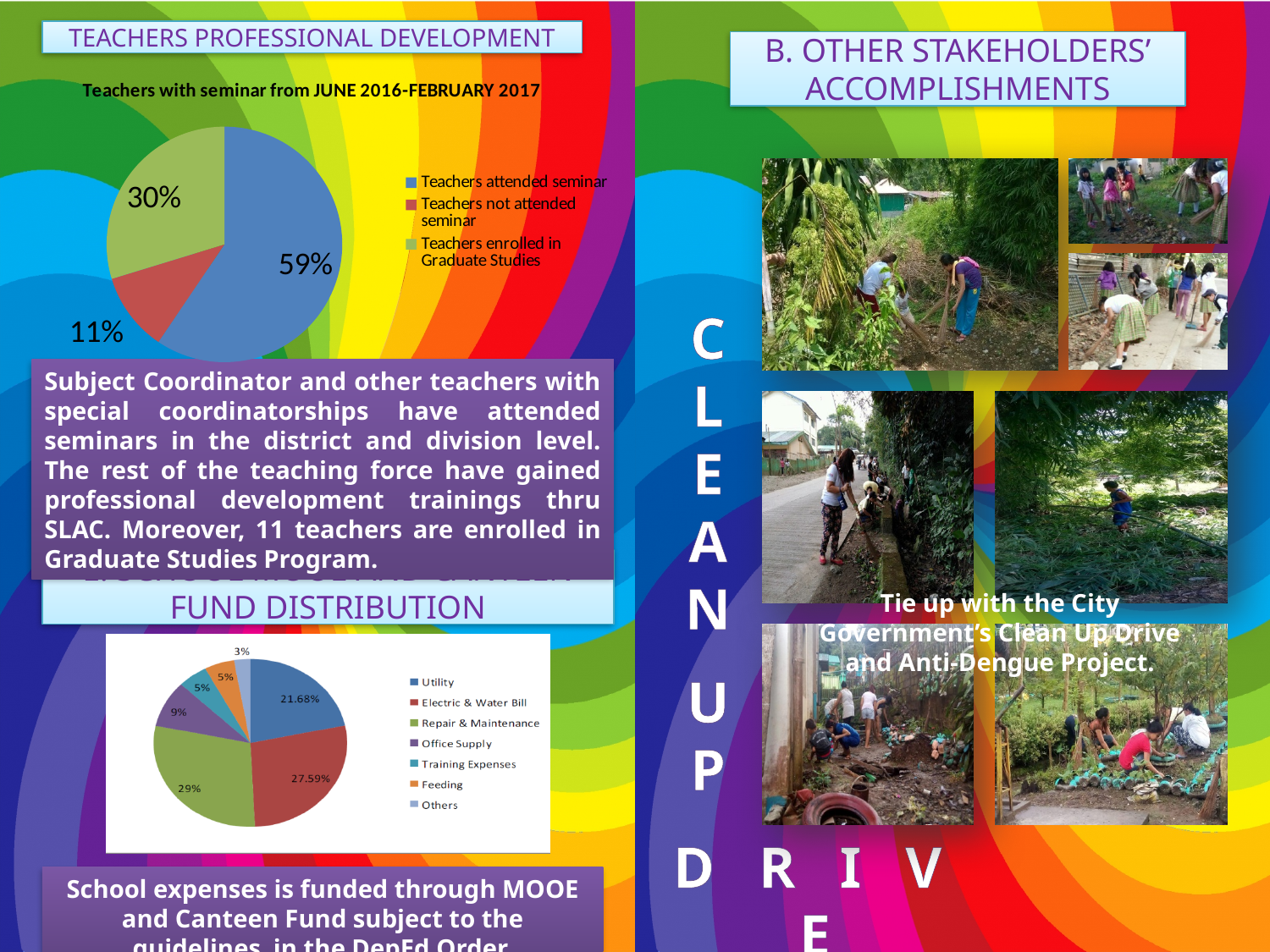
In the FUND DISTRIBUTION chart, what percentage is shown for Repair & Maintenance? 29% What type of chart is the 'Teachers with seminar from JUNE 2016-FEBRUARY 2017' chart? Pie chart In the FUND DISTRIBUTION chart, what percentage is shown for Utility? 21.68% In the FUND DISTRIBUTION chart, what is the difference between Electric & Water Bill (27.59%) and Utility (21.68%)? 5.91% In the 'Teachers with seminar from JUNE 2016-FEBRUARY 2017' chart, which category has the largest share? Teachers attended seminar In the FUND DISTRIBUTION chart, which is larger, Electric & Water Bill or Utility? Electric & Water Bill In the FUND DISTRIBUTION chart, what percentage is shown for Electric & Water Bill? 27.59% How many categories does the legend of the FUND DISTRIBUTION chart list? 7 In the 'Teachers with seminar from JUNE 2016-FEBRUARY 2017' chart, what is the difference between the largest slice (59%) and the 30% slice? 29% How many categories does the legend of the 'Teachers with seminar from JUNE 2016-FEBRUARY 2017' chart list? 3 In the 'Teachers with seminar from JUNE 2016-FEBRUARY 2017' chart, what percentage is shown for Teachers attended seminar? 59% In the FUND DISTRIBUTION chart, which category has the smallest share? Others